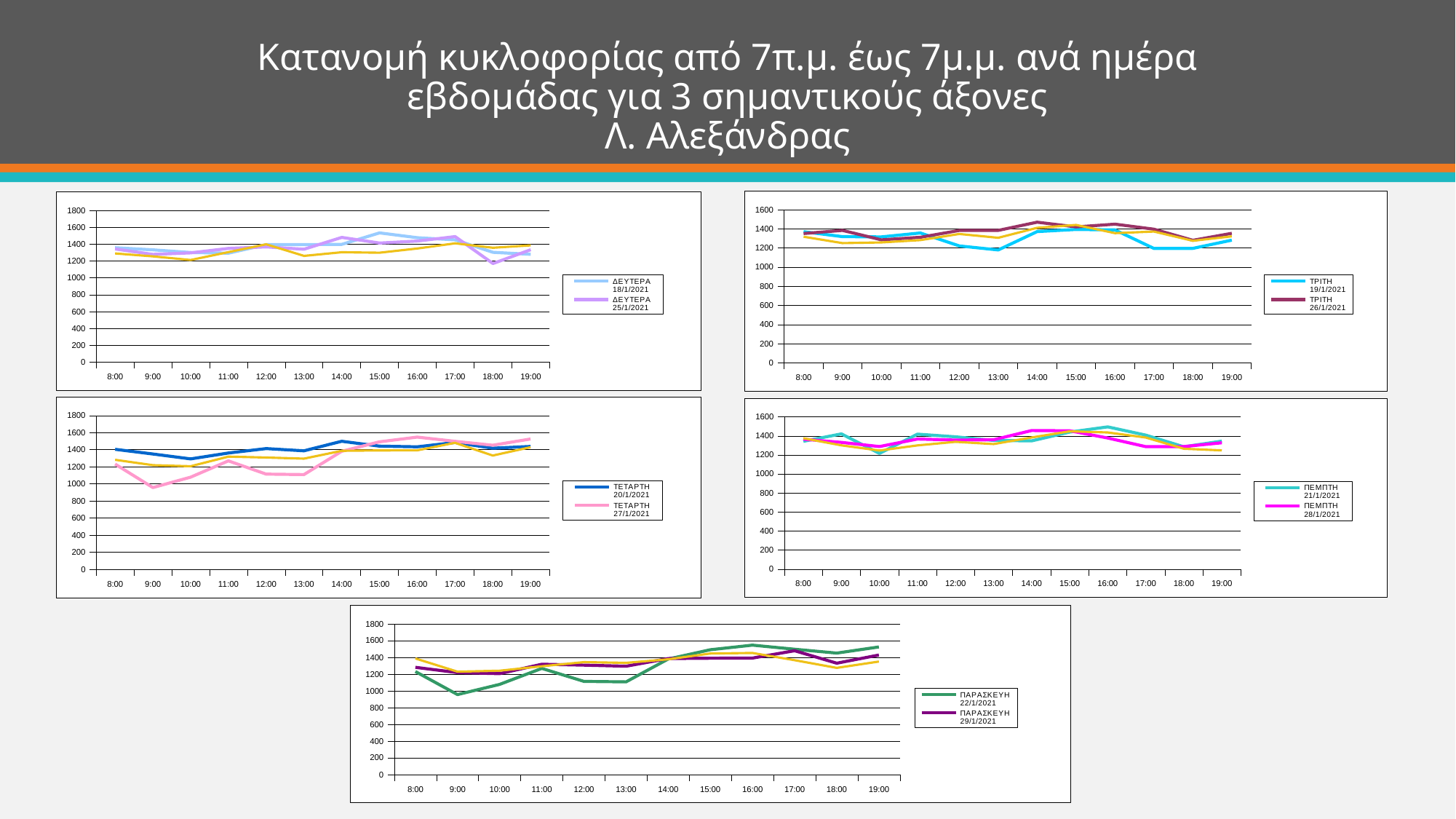
In the top-right chart, is the value for ΤΡΙΤΗ 19/1/2021 at 13:00 greater or less than 1400? less In the bottom chart, does the ΠΑΡΑΣΚΕΥΗ 22/1/2021 line rise or fall between 13:00 and 16:00? rise What kind of chart is the top-left chart on the slide? line chart In the middle-left chart, is the value for ΤΕΤΑΡΤΗ 27/1/2021 at 9:00 greater or less than 1000? less In the bottom chart, is the value for ΠΑΡΑΣΚΕΥΗ 22/1/2021 at 9:00 greater or less than 1000? less What are the two legend entries of the middle-right chart? ΠΕΜΠΤΗ 21/1/2021 and ΠΕΜΠΤΗ 28/1/2021 How many series does the legend of the top-right chart list? 2 In the middle-left chart, which series has the larger value at 9:00, ΤΕΤΑΡΤΗ 20/1/2021 or ΤΕΤΑΡΤΗ 27/1/2021? ΤΕΤΑΡΤΗ 20/1/2021 In the bottom chart, which series has the larger value at 9:00, ΠΑΡΑΣΚΕΥΗ 22/1/2021 or ΠΑΡΑΣΚΕΥΗ 29/1/2021? ΠΑΡΑΣΚΕΥΗ 29/1/2021 How many time points are plotted along the x axis of the bottom chart? 12